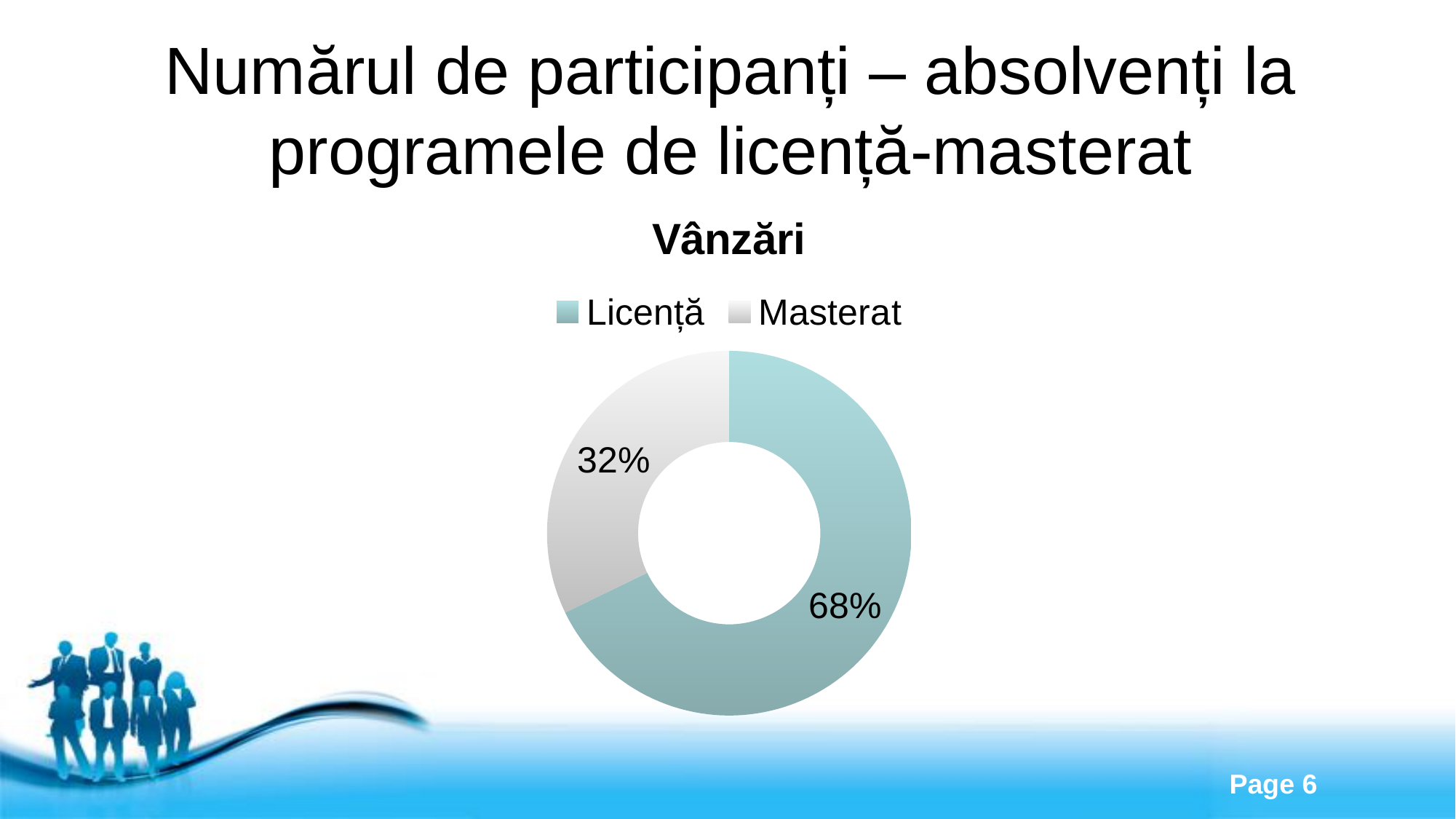
How many categories are shown in the chart? 2 Is the share for Masterat greater or less than 50%? less What share of the chart does Masterat represent? 32% Which is larger, the share for Licență or the share for Masterat? Licență Which category is shown in the teal colour? Licență What is the difference in percentage points between the Licență and Masterat shares? 36 What share of the chart does Licență represent? 68% What is the title of the chart? Vânzări What kind of chart is shown on the slide? Doughnut chart How many entries does the legend list? 2 Which category has the smallest share? Masterat Which category has the largest share? Licență